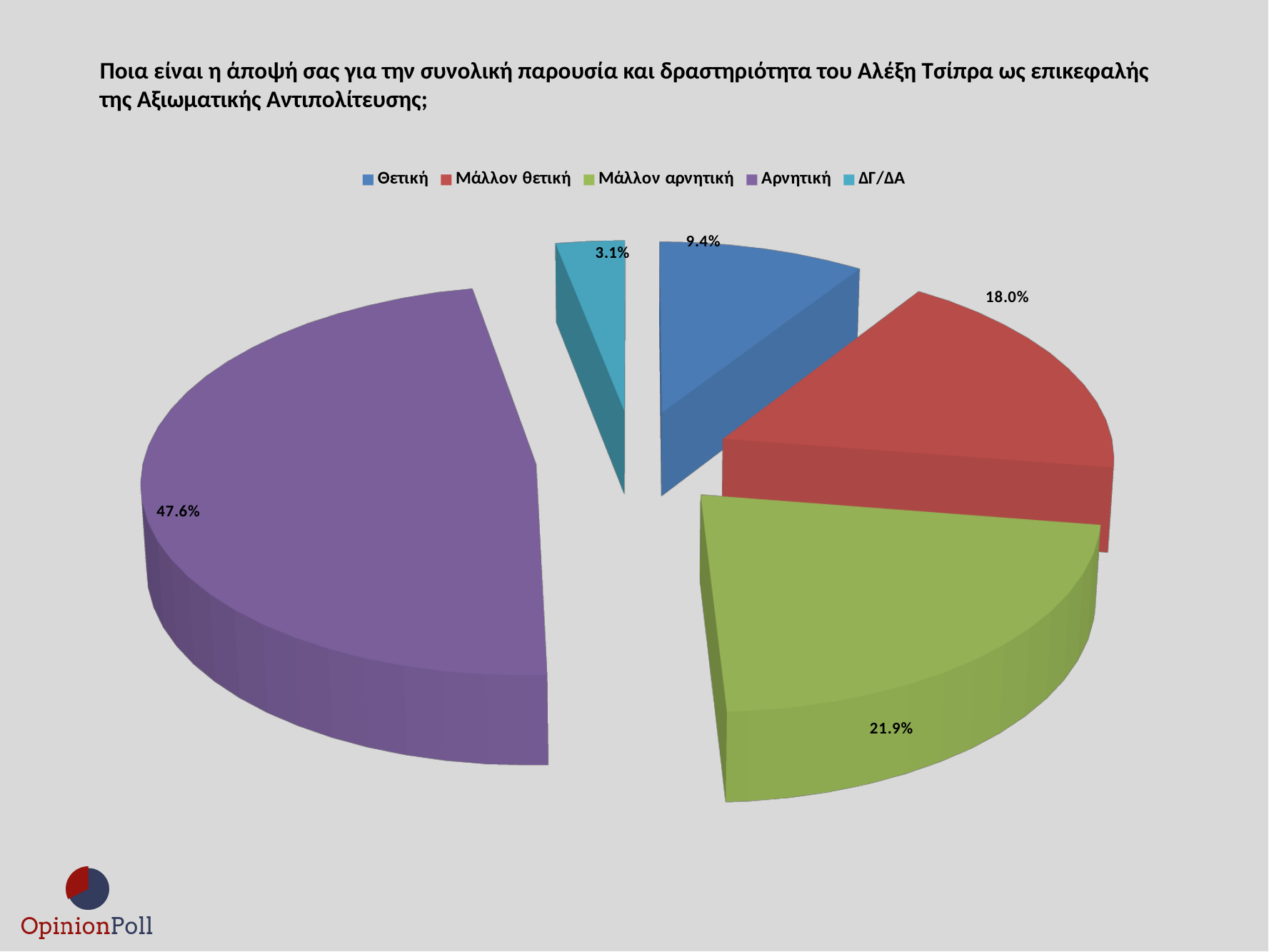
What is the value for Μάλλον θετική? 18.0% Which category has the smallest slice? ΔΓ/ΔΑ What is the value for ΔΓ/ΔΑ? 3.1% How many categories does the pie chart show? 5 What is the value for Θετική? 9.4% Which category has the largest slice? Αρνητική What is the value for Μάλλον αρνητική? 21.9% What share of the pie does Αρνητική have? 47.6% What is the difference between the values for Μάλλον αρνητική and Μάλλον θετική? 3.9% Which is larger, the value for Θετική or the value for Μάλλον θετική? Μάλλον θετική What colour is the slice for Αρνητική? Purple What kind of chart is shown on the slide? Pie chart